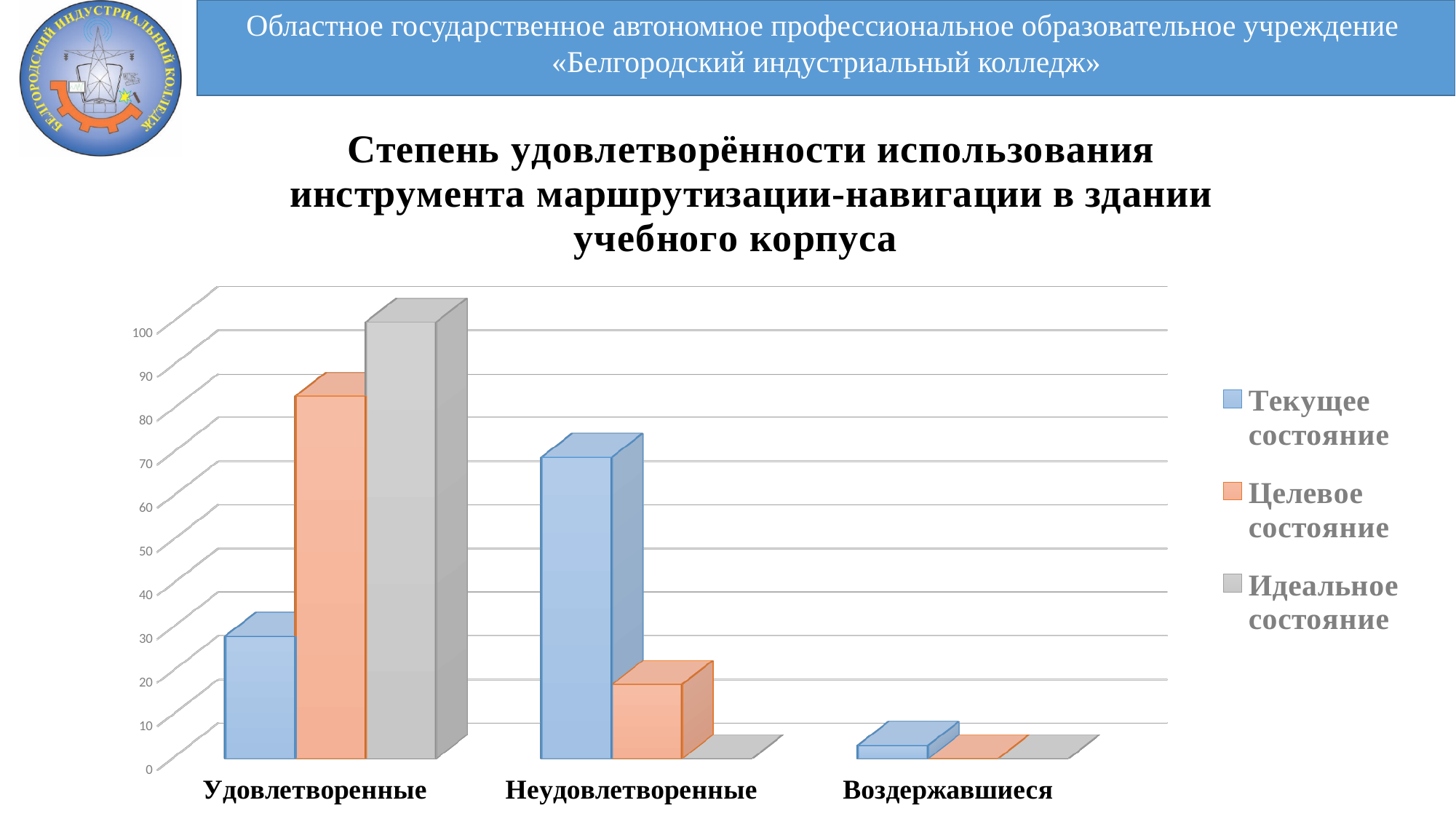
Is the value for Целевое состояние in the Удовлетворенные category greater or less than 80? greater What kind of chart is shown on the slide? bar chart Which category has the highest value for the Текущее состояние series? Неудовлетворенные Which category has the lowest value for the Текущее состояние series? Воздержавшиеся In the Удовлетворенные category, which is larger: Текущее состояние or Целевое состояние? Целевое состояние Is the value for Целевое состояние in the Неудовлетворенные category greater or less than 30? less How many series does the legend list? 3 Is the value for Текущее состояние in the Неудовлетворенные category greater or less than 60? greater Which series is shown in orange in the legend? Целевое состояние Which category has the highest value for the Идеальное состояние series? Удовлетворенные How many categories are shown on the x axis? 3